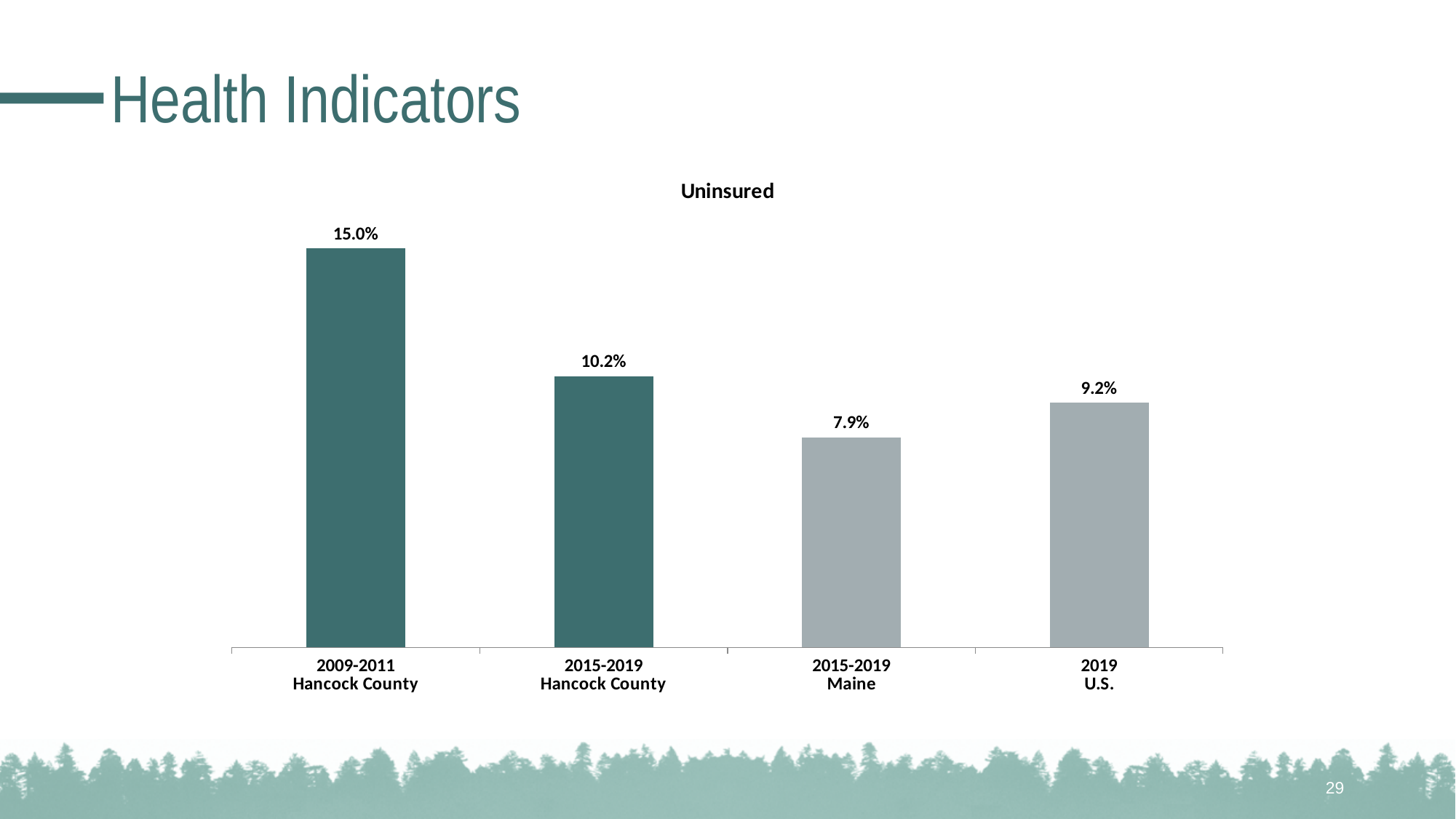
Which is larger, the 2015-2019 Hancock County uninsured rate or the 2019 U.S. uninsured rate? 2015-2019 Hancock County How many bars are shown in the Uninsured chart? 4 By how many percentage points did the Hancock County uninsured rate change from 2009-2011 to 2015-2019? 4.8 percentage points Which category has the highest uninsured rate? 2009-2011 Hancock County What type of chart is shown on the slide? Bar chart What is the difference between the 2019 U.S. uninsured rate and the 2015-2019 Maine uninsured rate? 1.3 percentage points What is the uninsured rate for Hancock County in 2009-2011? 15.0% What is the title of the chart? Uninsured What is the uninsured rate for the U.S. in 2019? 9.2% What is the uninsured rate for Maine in 2015-2019? 7.9% What is the uninsured rate for Hancock County in 2015-2019? 10.2% Which category has the lowest uninsured rate? 2015-2019 Maine